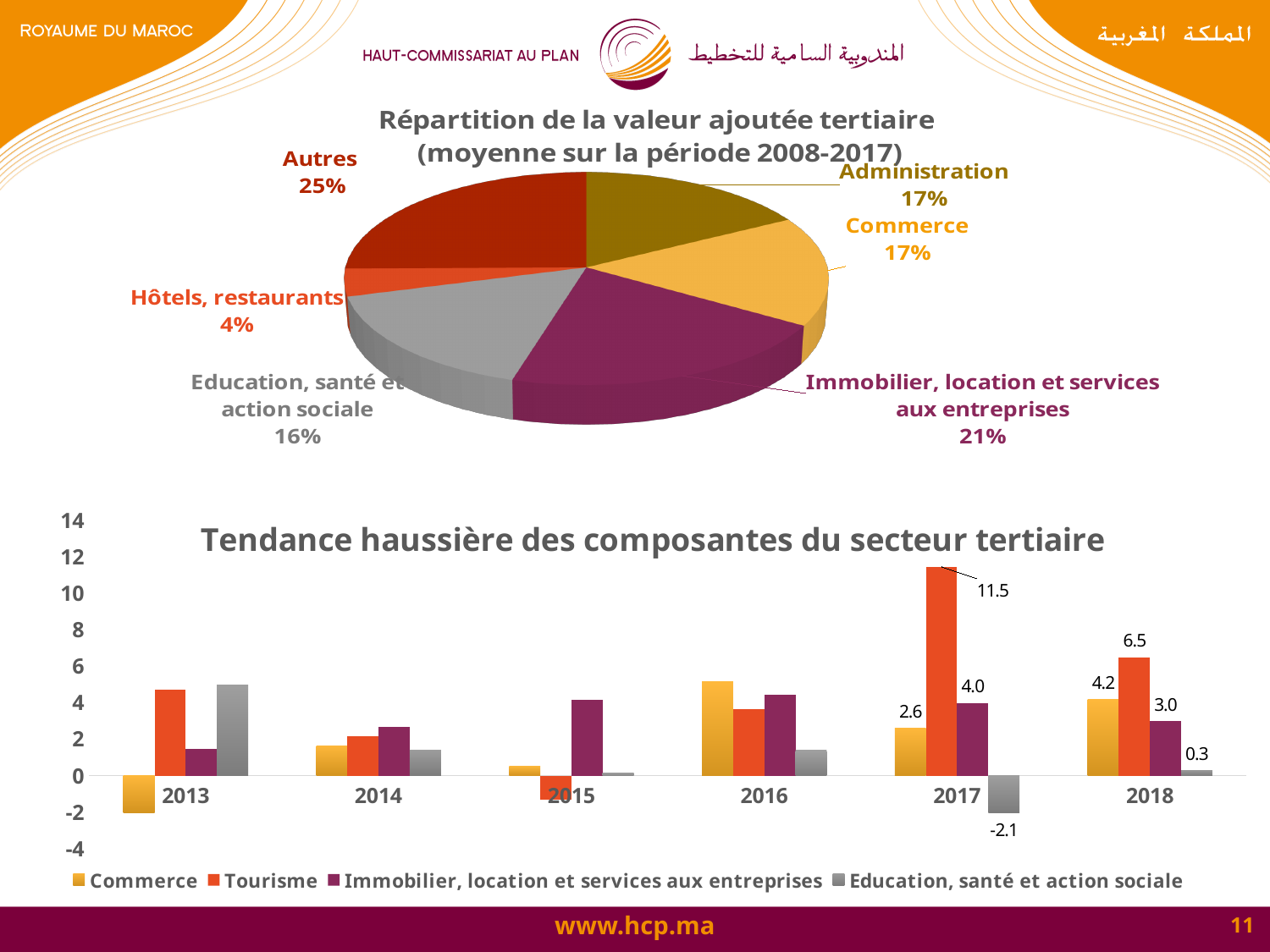
In the bar chart 'Tendance haussière des composantes du secteur tertiaire', what is the value for Tourisme in 2017? 11.5 In the pie chart 'Répartition de la valeur ajoutée tertiaire', what is the share of 'Immobilier, location et services aux entreprises'? 21% What kind of chart is the lower chart on the slide, 'Tendance haussière des composantes du secteur tertiaire'? Bar chart In the pie chart 'Répartition de la valeur ajoutée tertiaire', how many categories are shown? 6 In the pie chart 'Répartition de la valeur ajoutée tertiaire', which category has the smallest share? Hôtels, restaurants In the pie chart 'Répartition de la valeur ajoutée tertiaire', which category has the largest share? Autres In the pie chart 'Répartition de la valeur ajoutée tertiaire', what share does 'Autres' hold? 25% In the bar chart 'Tendance haussière des composantes du secteur tertiaire', is the value for Tourisme in 2017 greater or less than 10? greater In the bar chart 'Tendance haussière des composantes du secteur tertiaire', how many series does the legend list? 4 In the bar chart 'Tendance haussière des composantes du secteur tertiaire', what is the difference between the Tourisme values in 2017 and 2018? 5.0 In the pie chart 'Répartition de la valeur ajoutée tertiaire', what is the difference between the shares of 'Immobilier, location et services aux entreprises' and 'Education, santé et action sociale'? 5% In the bar chart 'Tendance haussière des composantes du secteur tertiaire', what is the value for 'Education, santé et action sociale' in 2017? -2.1